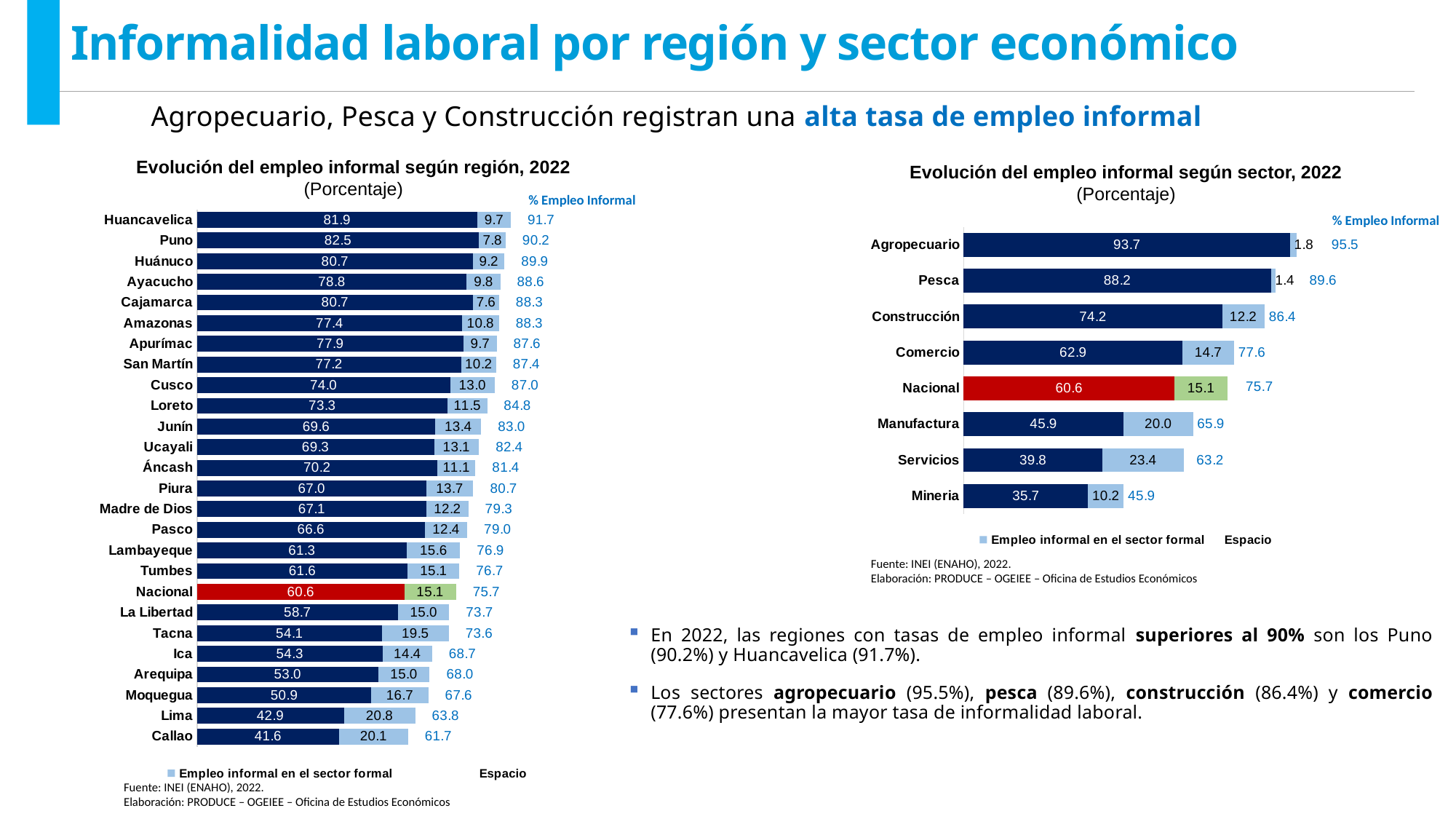
In the chart 'Evolución del empleo informal según sector, 2022', what is the difference between the % Empleo Informal of Agropecuario and Pesca? 5.9 In the chart 'Evolución del empleo informal según región, 2022', what is the difference between the % Empleo Informal of Nacional and Callao? 14.0 In the chart 'Evolución del empleo informal según sector, 2022', what is the value of the dark blue segment for Agropecuario? 93.7 In the chart 'Evolución del empleo informal según región, 2022', which has the larger dark blue segment value, Puno or Huancavelica? Puno In the chart 'Evolución del empleo informal según sector, 2022', which sector has the lowest % Empleo Informal? Mineria In the chart 'Evolución del empleo informal según región, 2022', what is the value of the light blue segment for Lima? 20.8 What kind of chart is 'Evolución del empleo informal según región, 2022'? Stacked bar chart In the chart 'Evolución del empleo informal según región, 2022', what is the % Empleo Informal total shown for Huancavelica? 91.7 In the chart 'Evolución del empleo informal según región, 2022', which region has the lowest % Empleo Informal? Callao In the chart 'Evolución del empleo informal según sector, 2022', what is the % Empleo Informal total shown for Mineria? 45.9 In the chart 'Evolución del empleo informal según sector, 2022', which sector has the highest % Empleo Informal? Agropecuario How many sectors are shown in the chart 'Evolución del empleo informal según sector, 2022'? 8